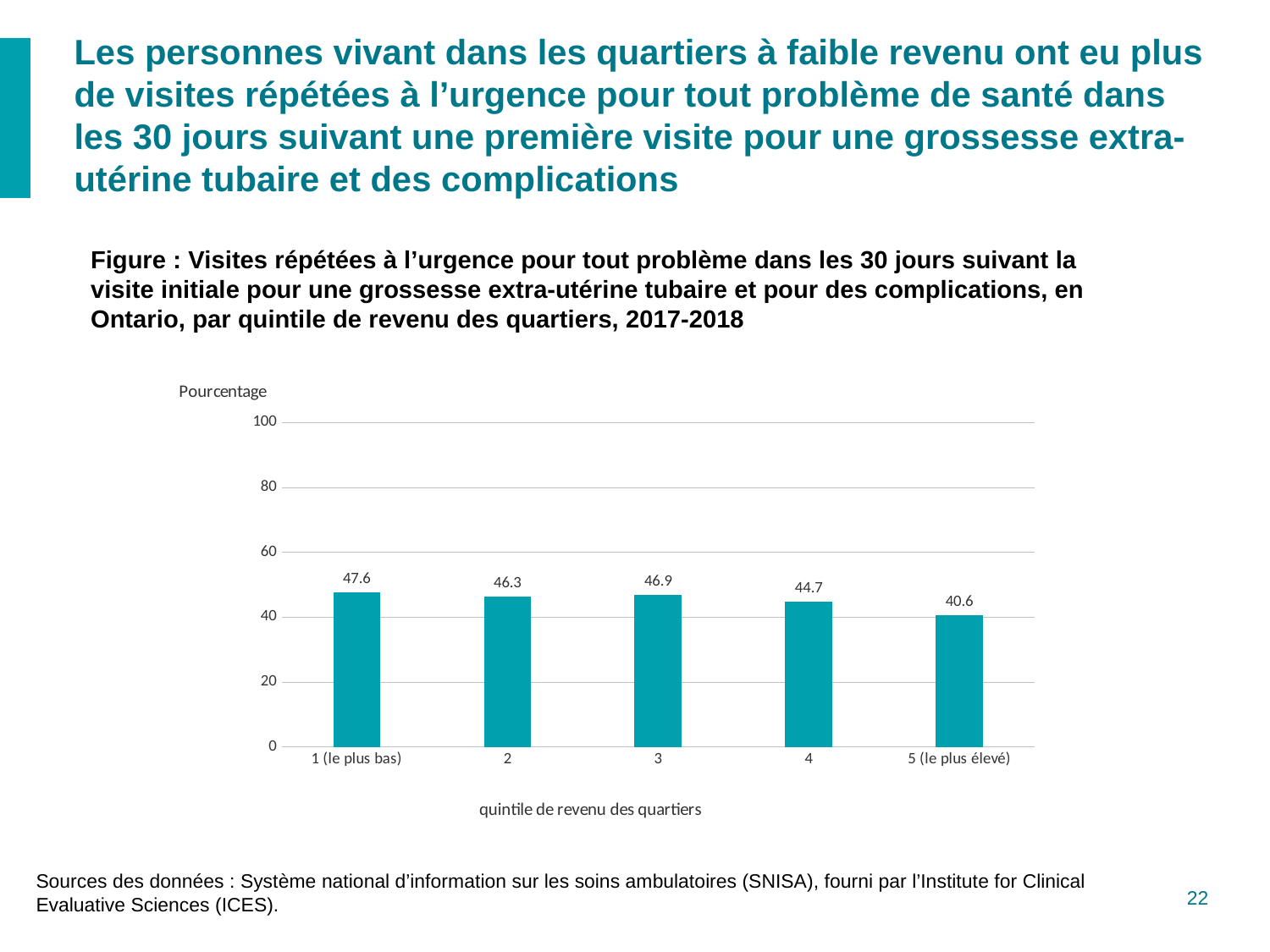
How many quintile categories are shown on the x axis? 5 What is the value for quintile 1 (le plus bas)? 47.6 Is the value for quintile 4 greater or less than 40? greater Which quintile has the highest value? 1 (le plus bas) Which quintile has the lowest value? 5 (le plus élevé) What is the difference between the values for quintile 3 and quintile 4? 2.2 What is the value for quintile 5 (le plus élevé)? 40.6 What is the value for quintile 3? 46.9 What kind of chart is shown on the slide? bar chart Which is larger, the value for quintile 2 or the value for quintile 4? 2 What is the difference between the values for quintile 1 (le plus bas) and quintile 5 (le plus élevé)? 7.0 What is the label of the x axis? quintile de revenu des quartiers